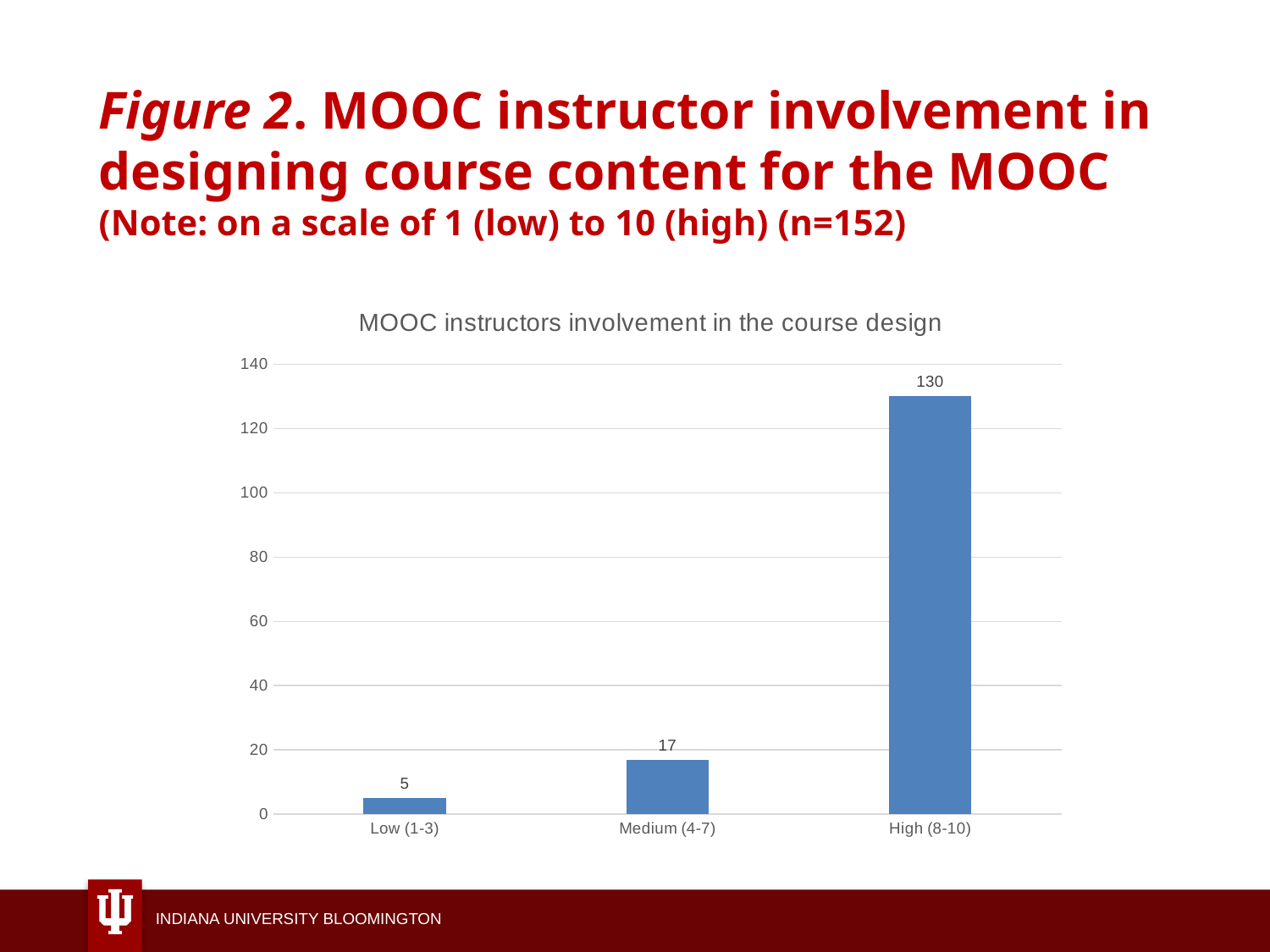
How many categories are shown on the x axis? 3 Which category has the lowest value? Low (1-3) Which is larger, the value for Medium (4-7) or the value for Low (1-3)? Medium (4-7) What is the value for High (8-10)? 130 What is the value for Medium (4-7)? 17 What is the difference between the values for High (8-10) and Medium (4-7)? 113 What is the value for Low (1-3)? 5 What kind of chart is shown on the slide? bar chart What is the title of the chart? MOOC instructors involvement in the course design Is the value for High (8-10) greater or less than 120? greater Which category has the highest value? High (8-10) What is the difference between the values for Medium (4-7) and Low (1-3)? 12